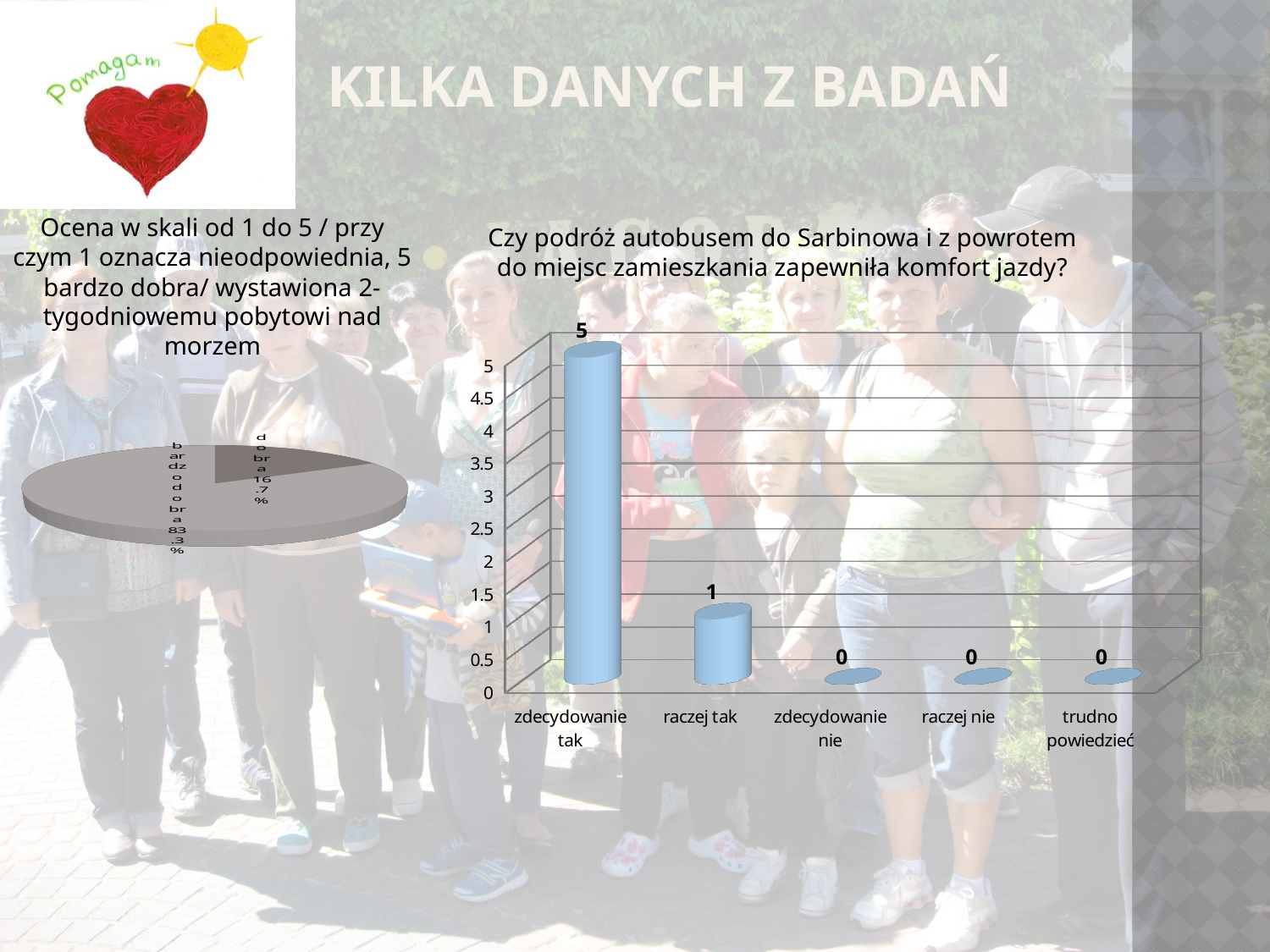
In the bar chart on the right, what is the value for "raczej tak"? 1 In the bar chart on the right, what is the value for "zdecydowanie tak"? 5 In the bar chart on the right, what is the difference between the values for "zdecydowanie tak" and "raczej tak"? 4 What kind of chart is the chart on the left of the slide? pie chart What kind of chart is the chart on the right of the slide? bar chart In the pie chart on the left, what share does the "bardzo dobra" slice have? 83.3% In the bar chart on the right, which category has the highest value? zdecydowanie tak In the pie chart on the left, what share does the "dobra" slice have? 16.7% In the bar chart on the right, how many categories have a value of 0? 3 In the bar chart on the right, which is larger: the value for "zdecydowanie tak" or the value for "raczej tak"? zdecydowanie tak In the bar chart on the right, what is the value for "trudno powiedzieć"? 0 How many categories are shown in the bar chart on the right? 5